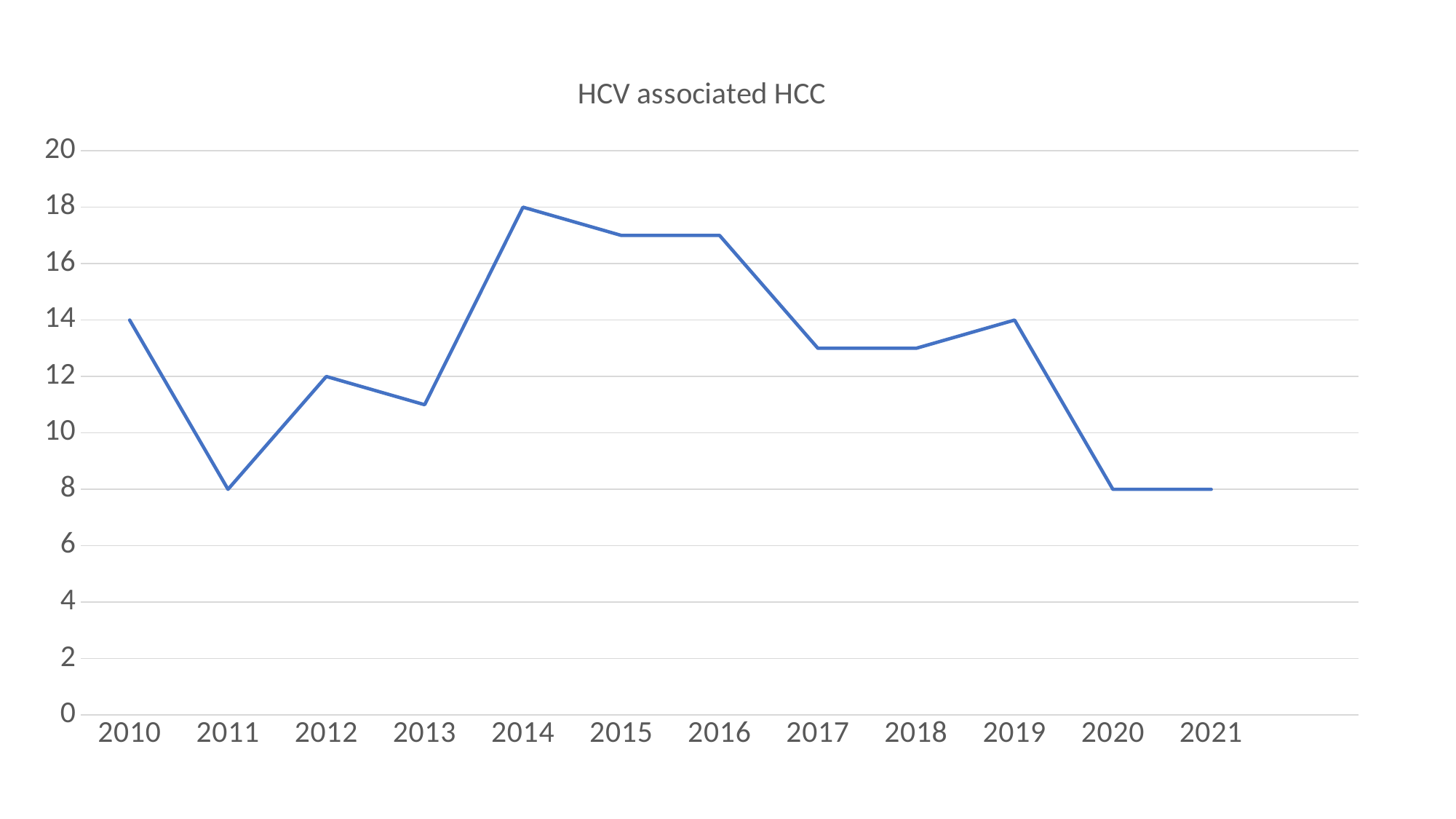
Which year has the highest value? 2014 What is the value for 2014? 18 What is the value for 2012? 12 What is the difference between the values for 2014 and 2011? 10 How many years are plotted on the x axis? 12 Which is larger, the value for 2010 or the value for 2012? 2010 What is the value for 2010? 14 What type of chart is shown on the slide? line chart Is the value for 2015 greater or less than 16? greater What is the value for 2011? 8 Do the values rise or fall from 2019 to 2021? fall What is the title of the chart? HCV associated HCC